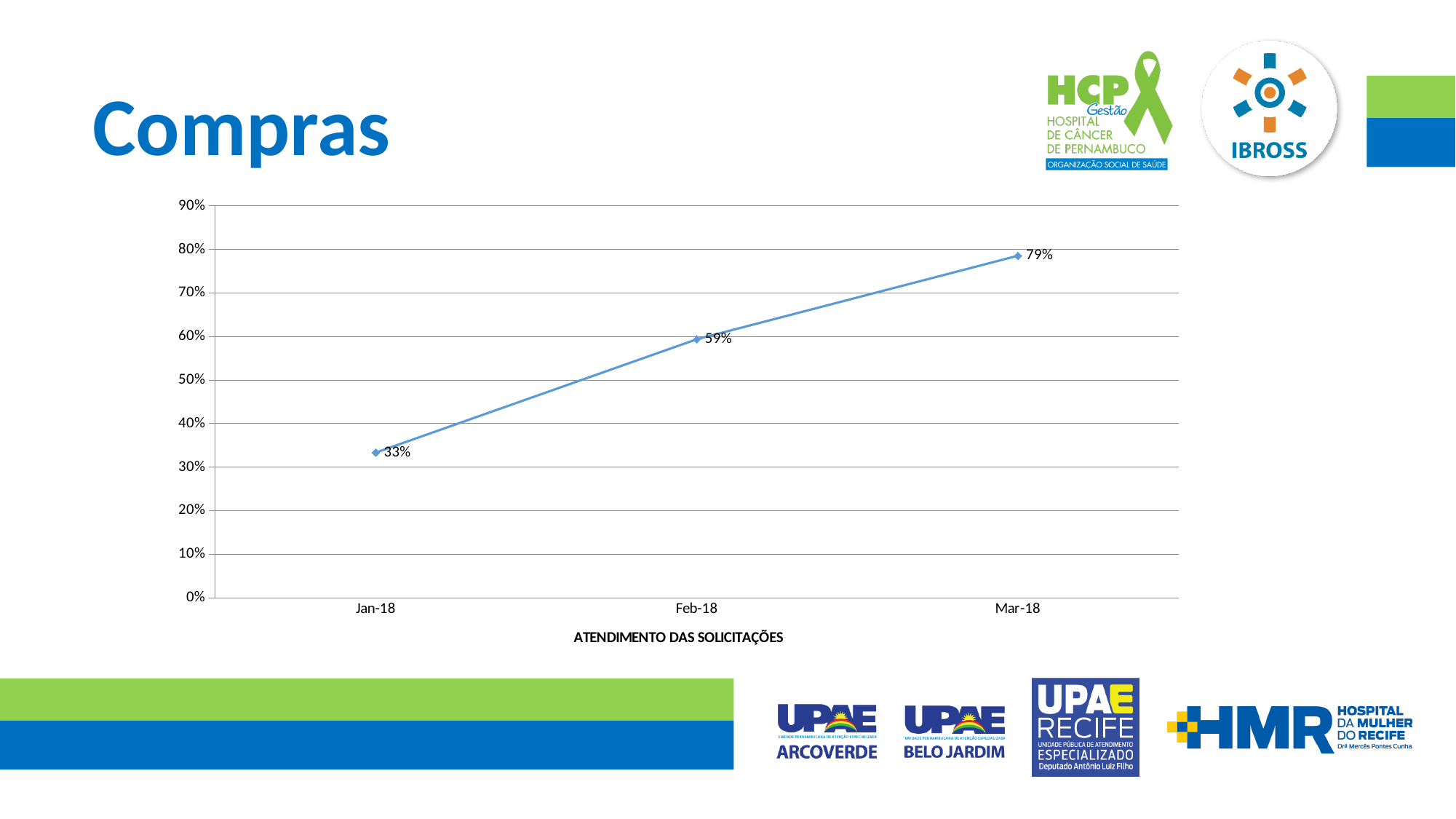
What is the value for Mar-18? 79% Do the values rise or fall from Jan-18 to Mar-18? Rise What is the value for Jan-18? 33% What is the difference between the values for Feb-18 and Jan-18? 26% How many data points are plotted on the chart? 3 What is the value for Feb-18? 59% Which month has the lowest value? Jan-18 Which is larger, the value for Feb-18 or the value for Mar-18? Mar-18 Which month has the highest value? Mar-18 What kind of chart is shown on the slide? Line chart What is the difference between the values for Mar-18 and Jan-18? 46% Is the value for Feb-18 greater or less than 50%? greater